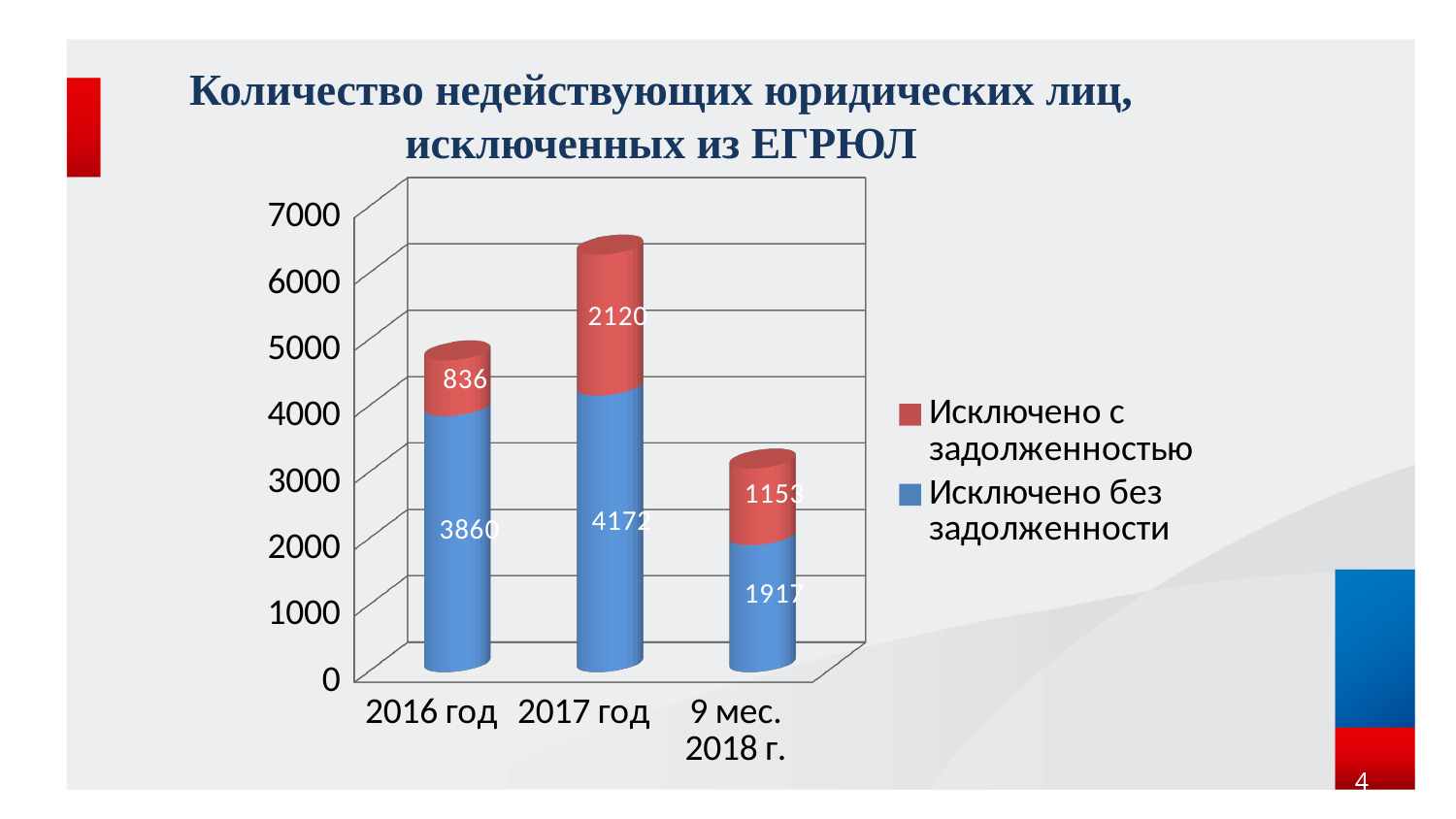
What kind of chart is shown on the slide? Stacked bar chart How many series does the legend list? 2 What is the value for "Исключено с задолженностью" for 9 мес. 2018 г.? 1153 Which category has the lowest value for "Исключено без задолженности"? 9 мес. 2018 г. What is the difference between the "Исключено без задолженности" values for 2017 год and 2016 год? 312 How many categories are shown on the x axis? 3 What is the value for "Исключено без задолженности" in 2017 год? 4172 What is the total of the stacked bar for 2016 год? 4696 What is the value for "Исключено с задолженностью" in 2016 год? 836 Which is larger: "Исключено с задолженностью" in 2017 год or in 9 мес. 2018 г.? 2017 год Which category has the highest value for "Исключено с задолженностью"? 2017 год What is the total of the stacked bar for 2017 год? 6292